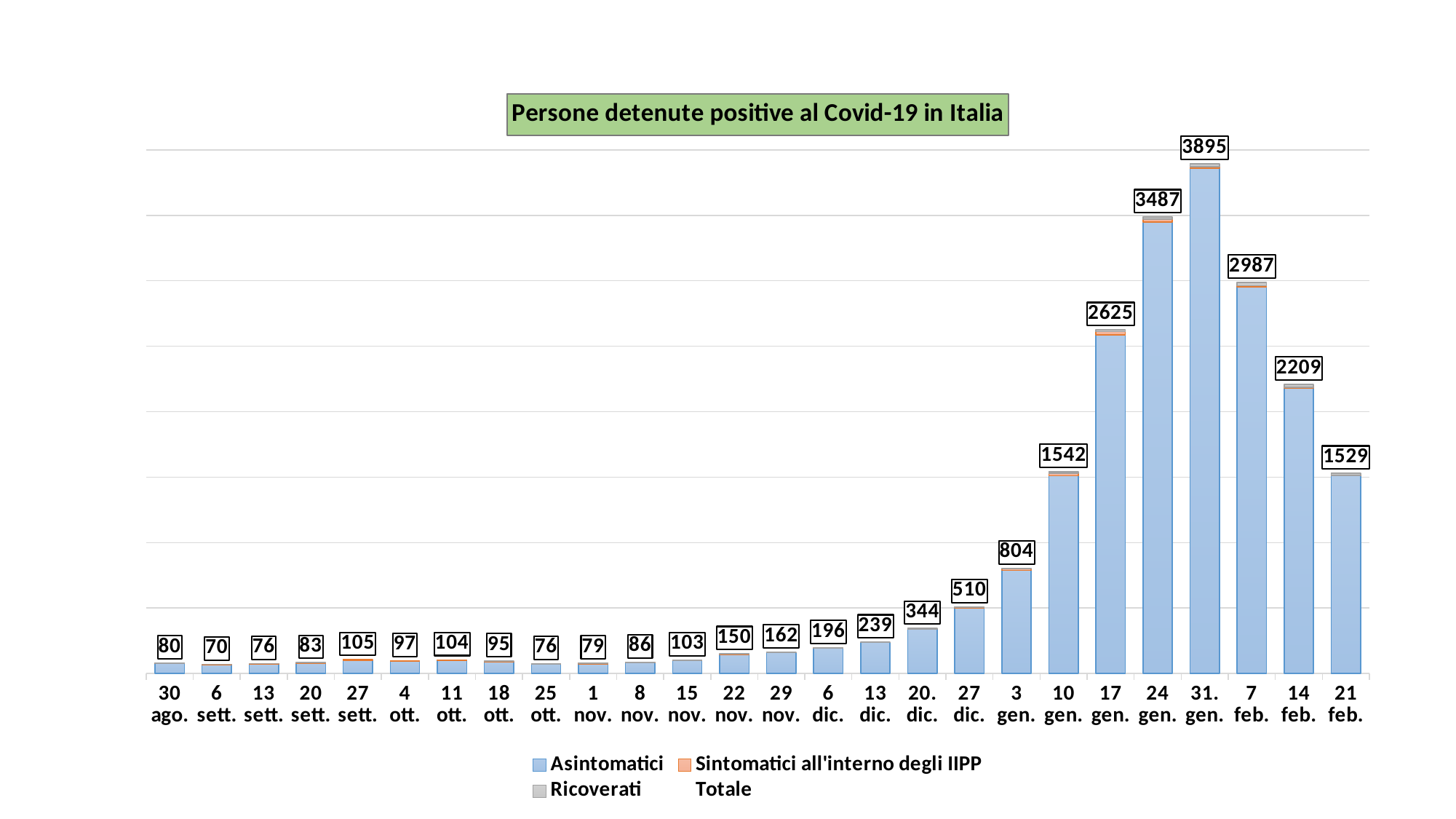
What is the difference between the totals for 24 gen. and 17 gen.? 862 Which date has the highest total of positive detainees? 31 gen. What is the total number of positive detainees shown for 31 gen.? 3895 Which date has the lowest total of positive detainees? 6 sett. What is the total value labelled for 21 feb.? 1529 How many dates are shown on the x axis? 26 What is the title of the chart? Persone detenute positive al Covid-19 in Italia What is the total value labelled for 10 gen.? 1542 What kind of chart is shown on the slide? Stacked bar chart What is the difference between the totals for 7 feb. and 14 feb.? 778 How many series does the legend list? 4 Which is larger, the total for 27 sett. or the total for 11 ott.? 27 sett.